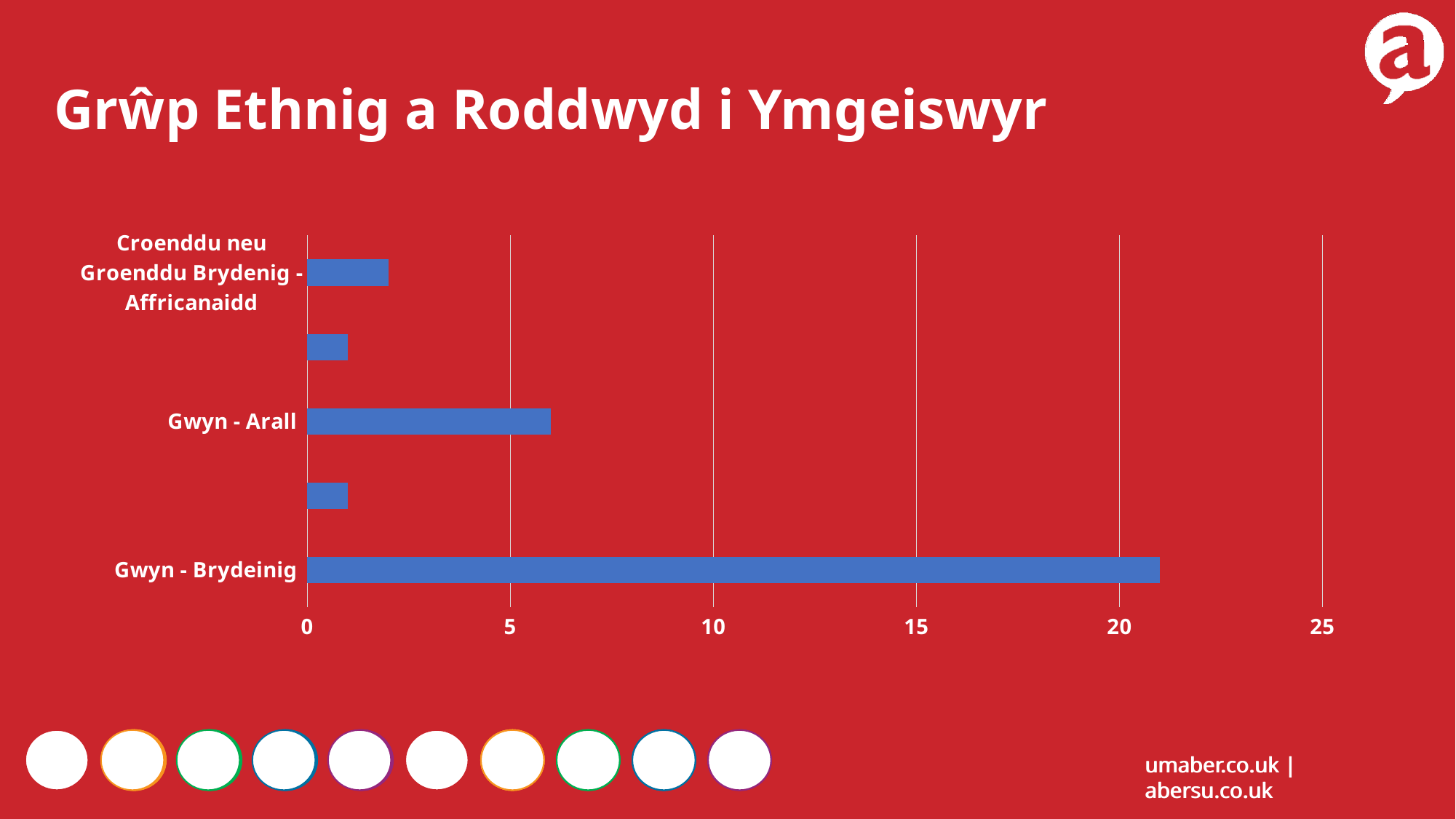
Is the value for Gwyn - Arall greater or less than 10? less Which is larger, the value for Gwyn - Brydeinig or the value for Gwyn - Arall? Gwyn - Brydeinig Which category has the highest value? Gwyn - Brydeinig How many bars are plotted in the chart? 5 What kind of chart is shown on the slide? bar chart What is the highest value shown on the horizontal axis? 25 Is the value for Croenddu neu Groenddu Brydenig - Affricanaidd greater or less than 5? less Which is larger, the value for Gwyn - Arall or the value for Croenddu neu Groenddu Brydenig - Affricanaidd? Gwyn - Arall Is the value for Gwyn - Brydeinig greater or less than 25? less What is the title of the chart? Grŵp Ethnig a Roddwyd i Ymgeiswyr